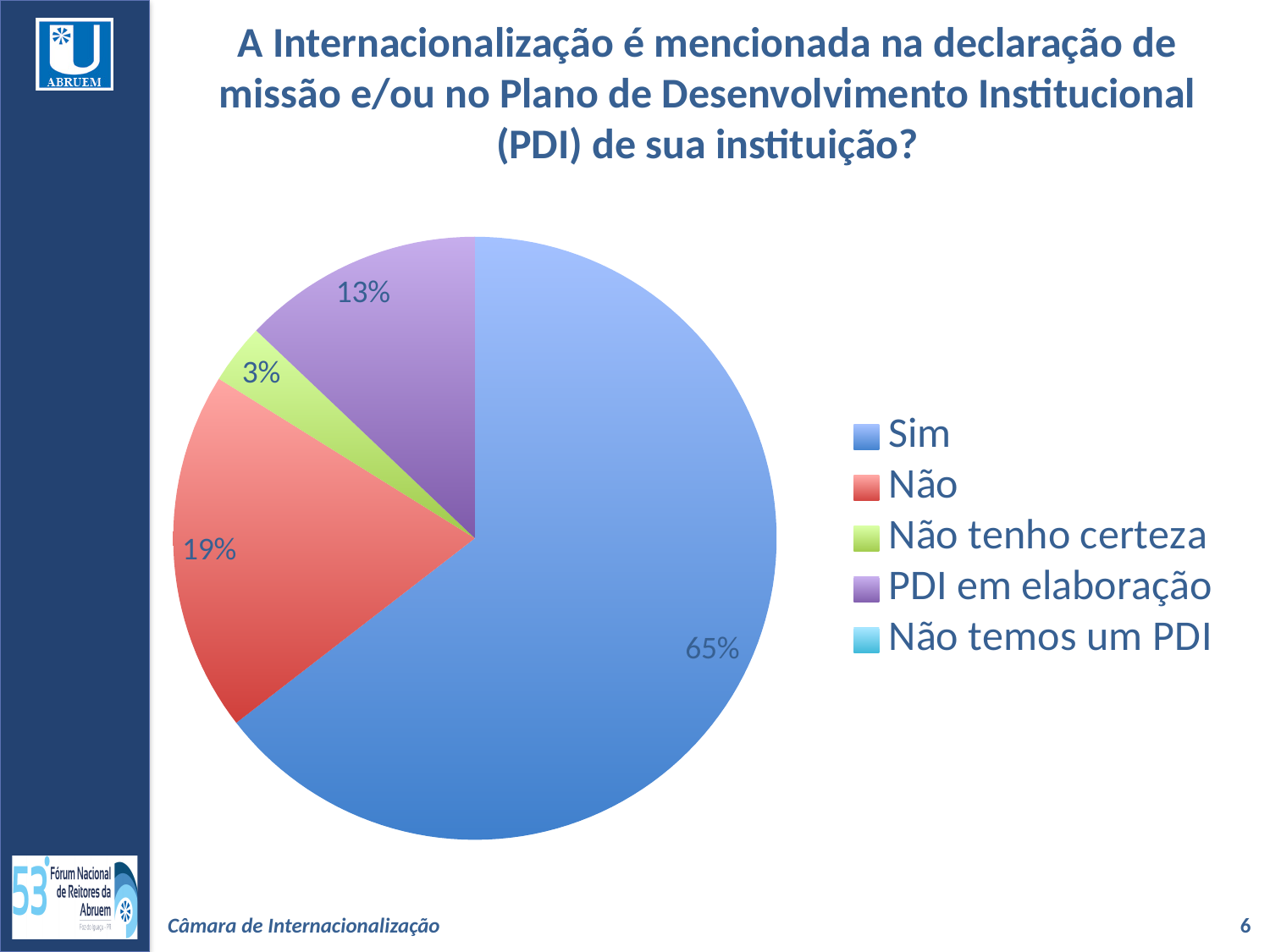
What share of the pie does "Sim" represent? 65% What share of the pie does "Não tenho certeza" represent? 3% Among the slices with printed labels, which category has the smallest share? Não tenho certeza Which legend entry has no visible slice in the pie? Não temos um PDI Which category has the largest slice of the pie? Sim What share of the pie does "PDI em elaboração" represent? 13% What is the difference in percentage points between the "Sim" and "Não" slices? 46 What colour is the "Sim" slice? blue What kind of chart is shown on the slide? pie chart Which is larger, the "Não" slice or the "PDI em elaboração" slice? Não How many entries does the legend list? 5